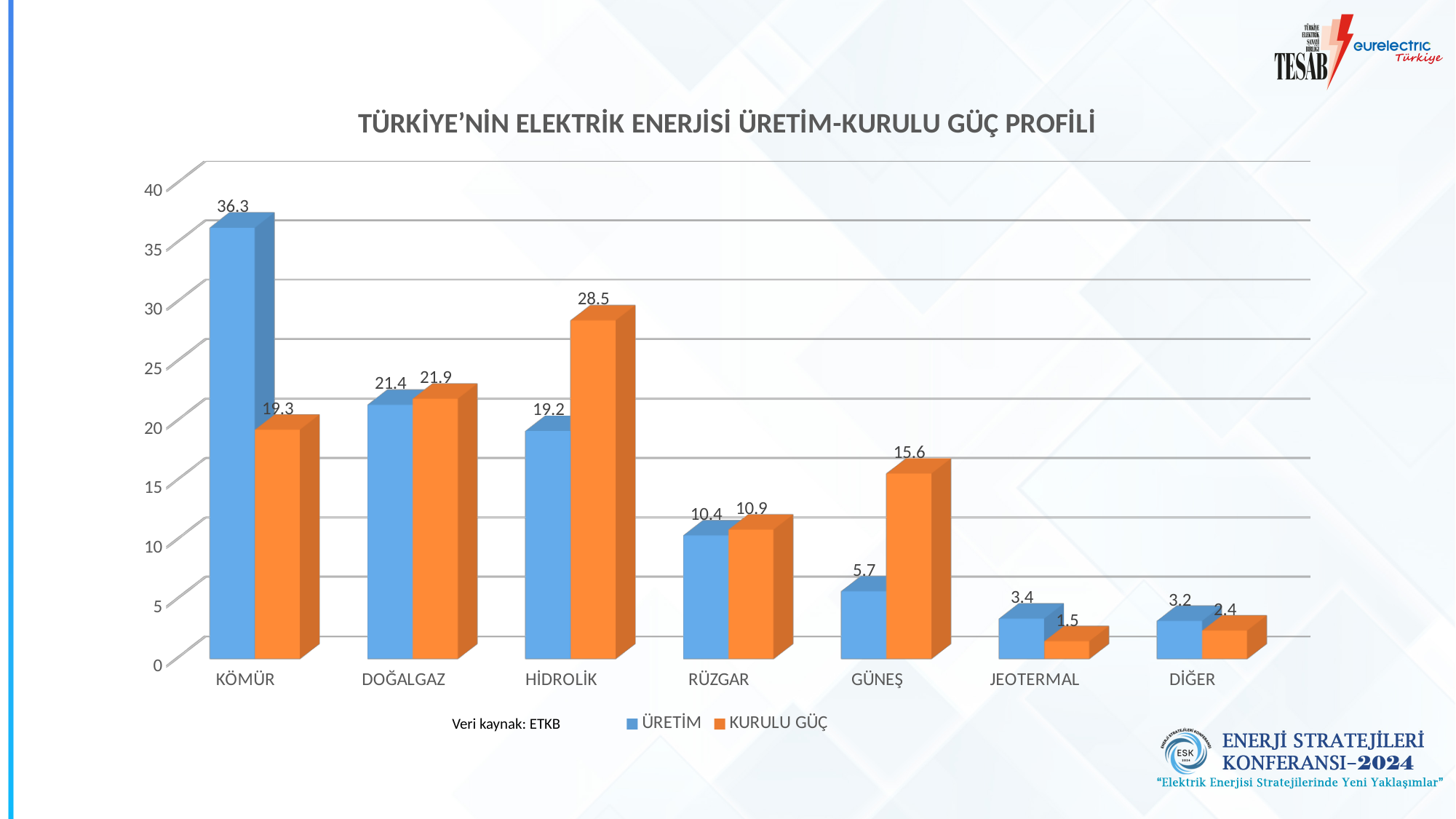
What is the KURULU GÜÇ value for JEOTERMAL? 1.5 Which category has the lowest KURULU GÜÇ value? JEOTERMAL How many categories are shown on the x axis? 7 What is the KURULU GÜÇ value for HİDROLİK? 28.5 How many series does the legend list? 2 For HİDROLİK, which is larger: ÜRETİM or KURULU GÜÇ? KURULU GÜÇ Which category has the highest ÜRETİM value? KÖMÜR What kind of chart is shown on the slide? Bar chart What is the ÜRETİM value for KÖMÜR? 36.3 What is the difference between the KURULU GÜÇ and ÜRETİM values for GÜNEŞ? 9.9 What is the title of the chart? TÜRKİYE'NİN ELEKTRİK ENERJİSİ ÜRETİM-KURULU GÜÇ PROFİLİ What is the difference between the ÜRETİM and KURULU GÜÇ values for KÖMÜR? 17.0